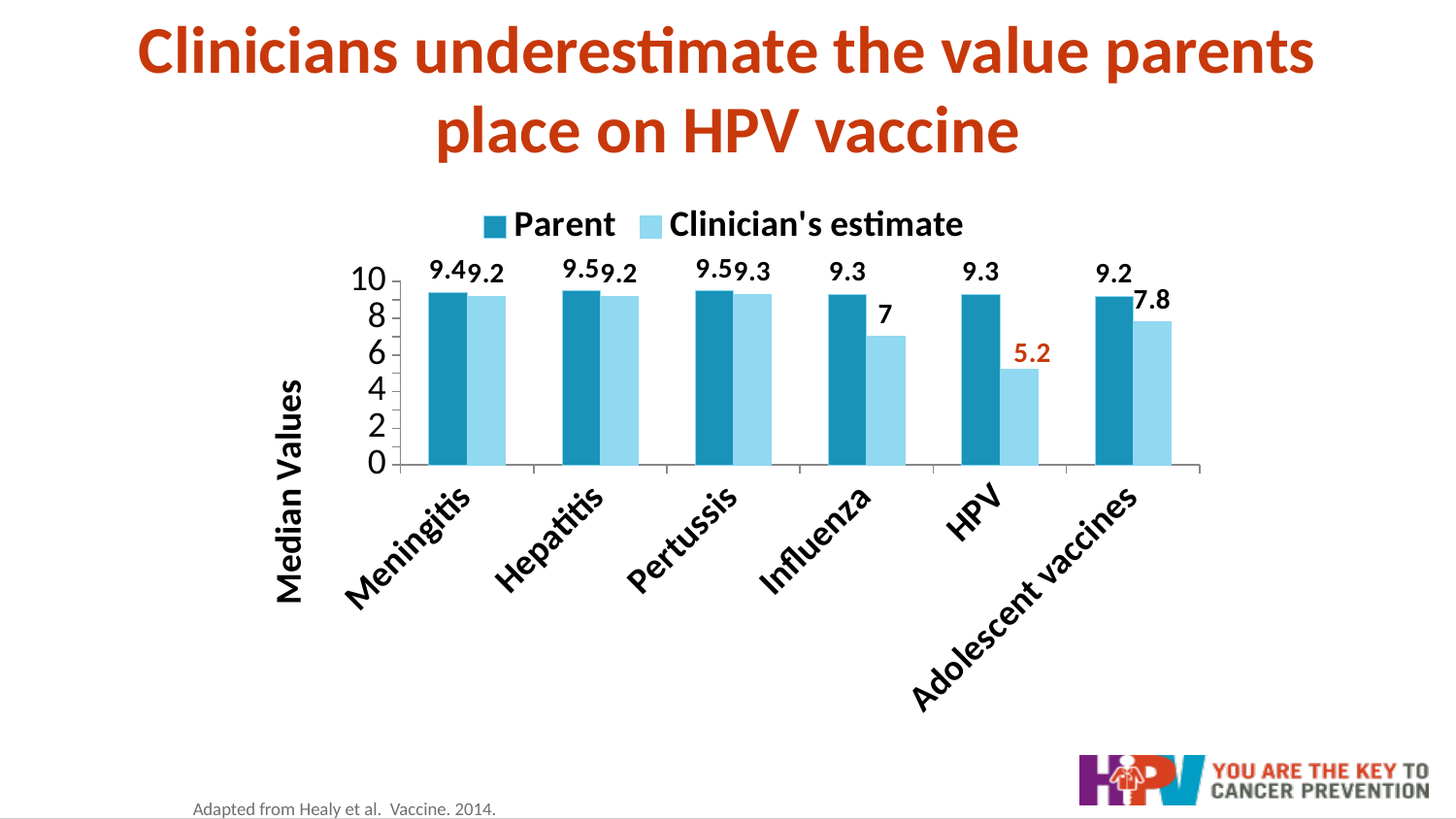
What kind of chart is shown on the slide? Bar chart What is the Clinician's estimate for Influenza? 7 What is the difference between the Parent value and the Clinician's estimate for HPV? 4.1 Which is larger for Influenza, the Parent value or the Clinician's estimate? Parent How many series does the legend list? 2 What is the Parent median value for Adolescent vaccines? 9.2 What is the Clinician's estimate for HPV? 5.2 Which category has the lowest Clinician's estimate? HPV What is the Parent median value for HPV? 9.3 How many vaccine categories are shown on the x axis? 6 What is the label on the vertical axis? Median Values What is the difference between the Parent value and the Clinician's estimate for Adolescent vaccines? 1.4